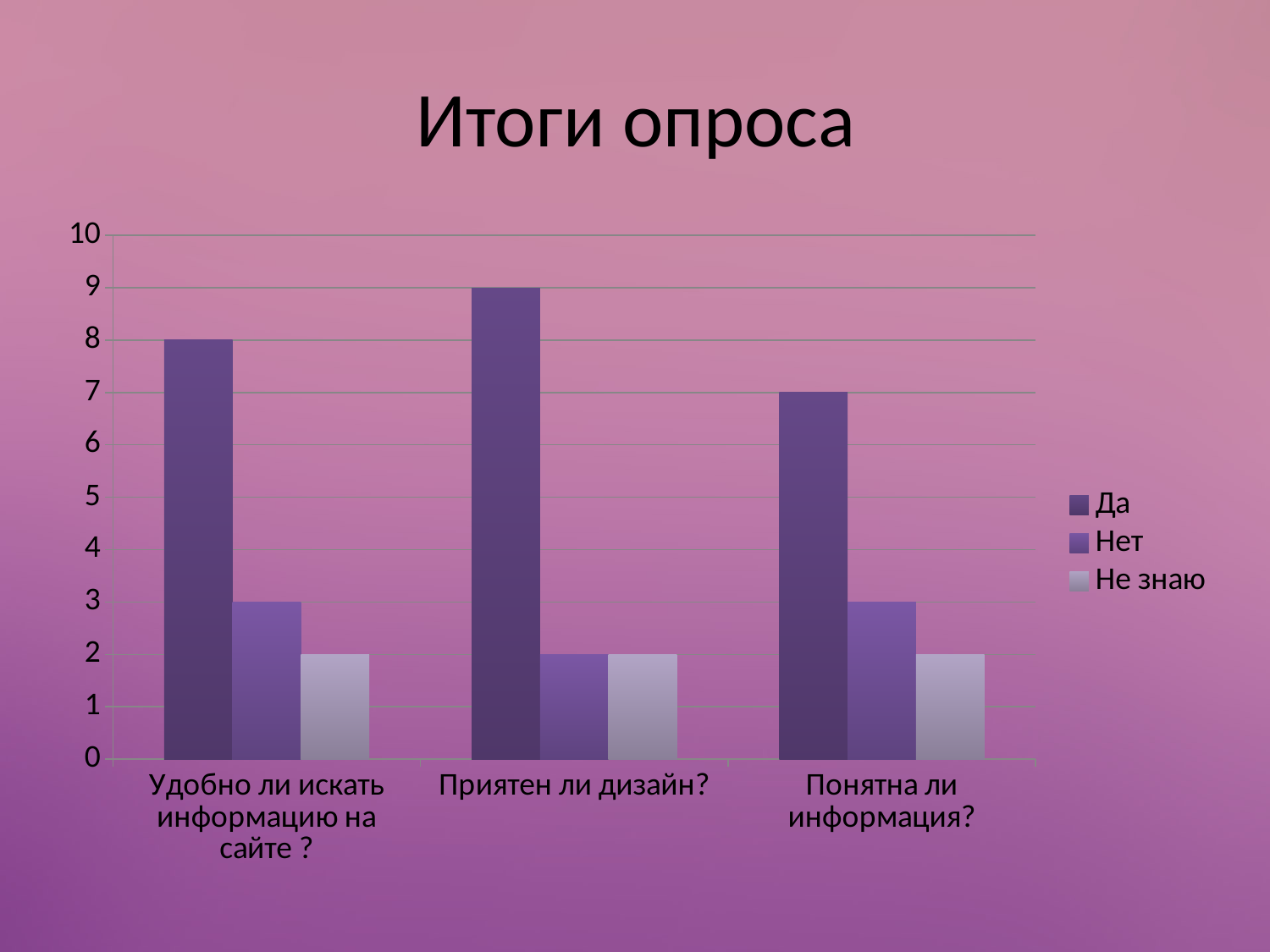
How many categories are shown on the x axis? 3 How many series does the legend list? 3 Which category has the lowest value for "Да"? Понятна ли информация? What kind of chart is shown on the slide? bar chart What is the title of the chart? Итоги опроса What is the difference between the "Да" values for "Приятен ли дизайн?" and "Понятна ли информация?"? 2 What is the value of "Нет" for "Удобно ли искать информацию на сайте ?"? 3 What is the value of "Не знаю" for "Приятен ли дизайн?"? 2 Which category has the highest value for "Да"? Приятен ли дизайн? Which is larger: "Нет" for "Удобно ли искать информацию на сайте ?" or "Нет" for "Приятен ли дизайн?"? Удобно ли искать информацию на сайте ? What is the value of "Да" for "Понятна ли информация?"? 7 What is the value of "Да" for "Приятен ли дизайн?"? 9